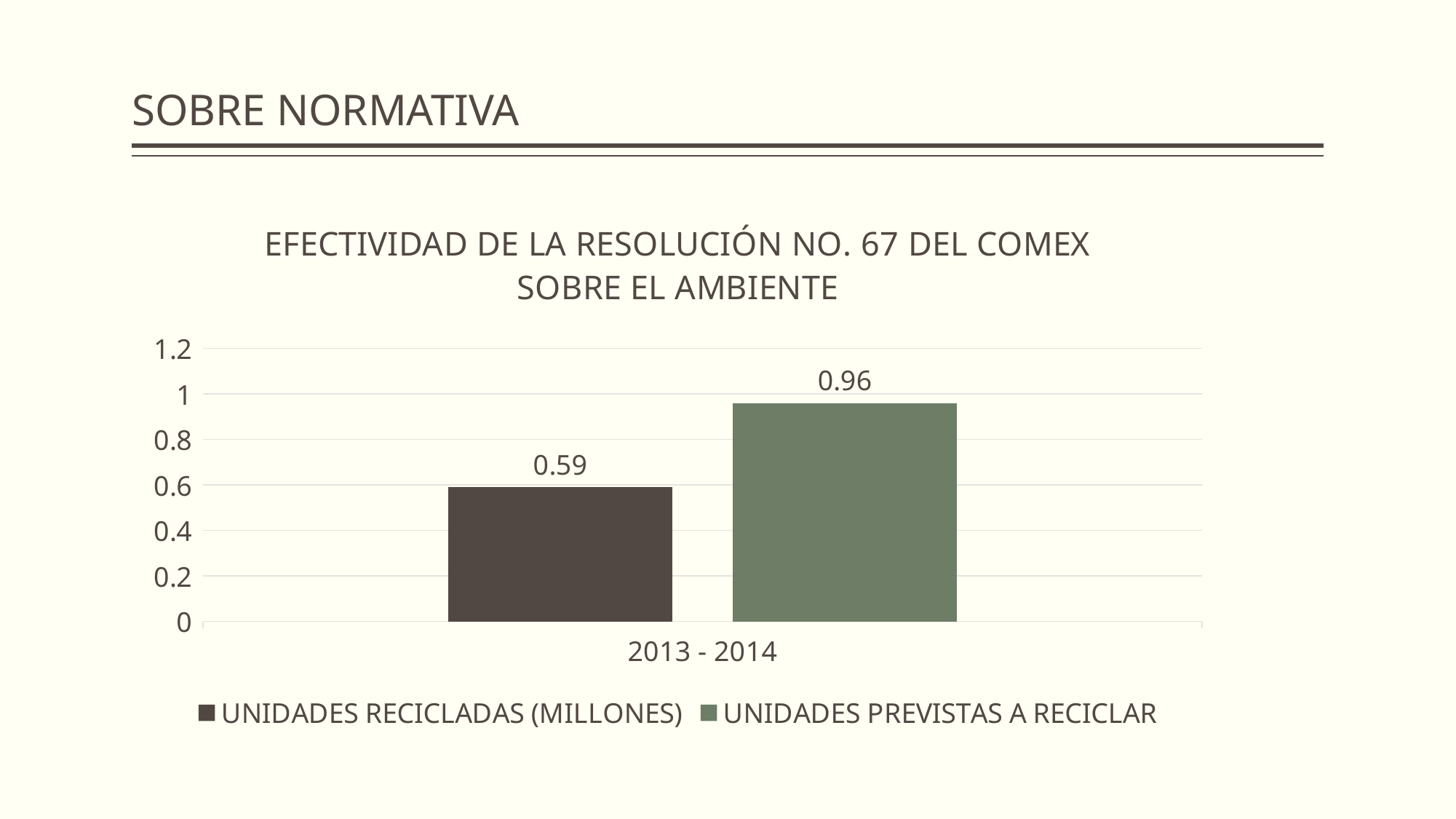
What is the value for UNIDADES RECICLADAS (MILLONES) in 2013 - 2014? 0.59 Is the value for UNIDADES RECICLADAS (MILLONES) larger or smaller than the value for UNIDADES PREVISTAS A RECICLAR? smaller What is the value for UNIDADES PREVISTAS A RECICLAR in 2013 - 2014? 0.96 How many series does the legend list? 2 What kind of chart is shown on the slide? bar chart How many categories are shown on the x axis? 1 What is the difference between UNIDADES PREVISTAS A RECICLAR and UNIDADES RECICLADAS (MILLONES)? 0.37 Is the value for UNIDADES PREVISTAS A RECICLAR greater or less than 1? less What is the title of the chart? EFECTIVIDAD DE LA RESOLUCIÓN NO. 67 DEL COMEX SOBRE EL AMBIENTE Which series has the lower value in 2013 - 2014? UNIDADES RECICLADAS (MILLONES) Is the value for UNIDADES RECICLADAS (MILLONES) greater or less than 0.4? greater Which series has the higher value in 2013 - 2014? UNIDADES PREVISTAS A RECICLAR